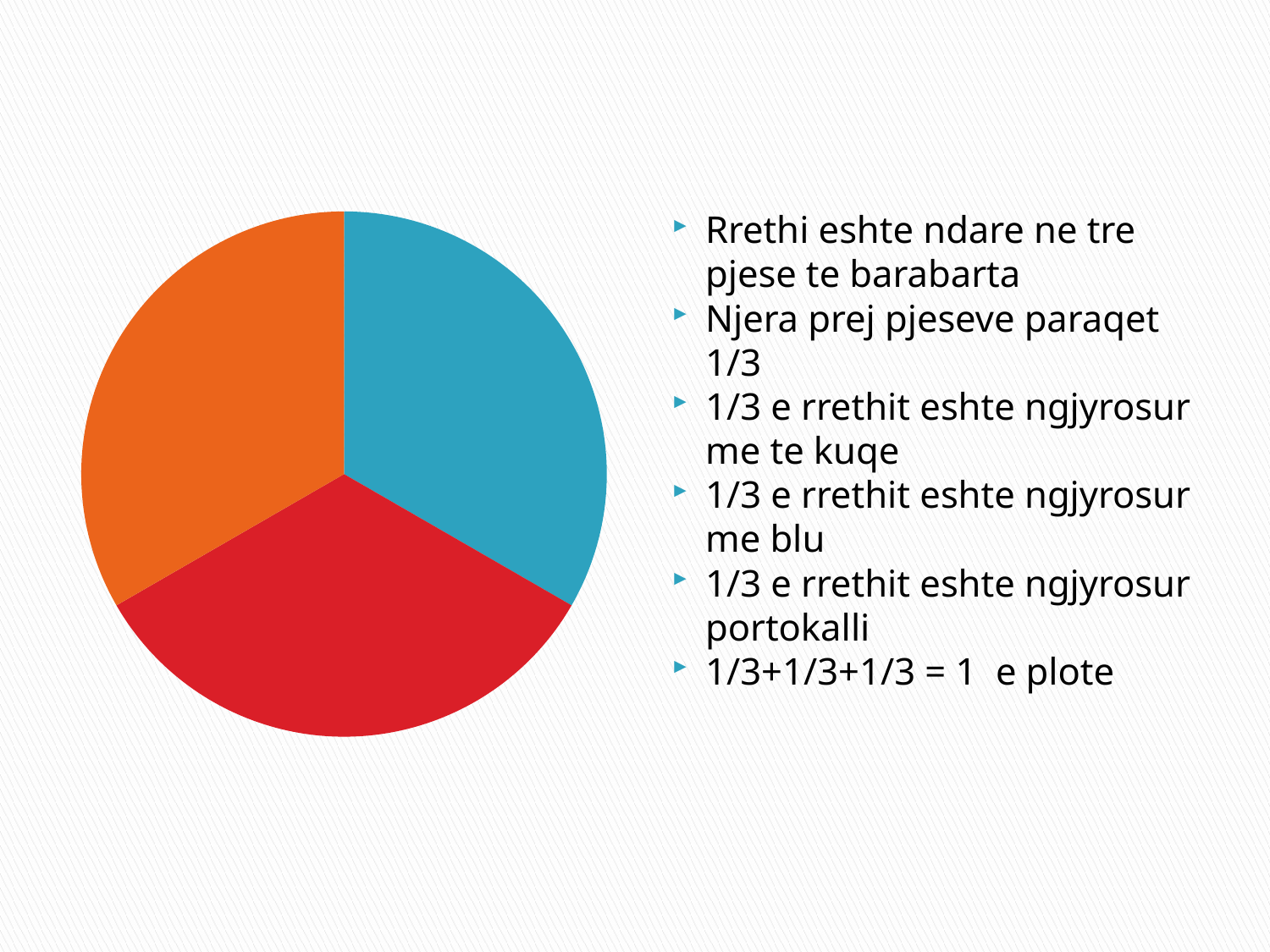
What share of the circle does the orange slice represent? 1/3 What share of the circle does the blue slice represent? 1/3 Are the three slices of the pie chart equal in size? yes Which three colours are used for the slices of the pie chart? blue, red and orange What do the three slices of the pie chart add up to, according to the slide? 1 What kind of chart is shown on the slide? pie chart What share of the circle does the red slice represent? 1/3 How many slices does the pie chart have? 3